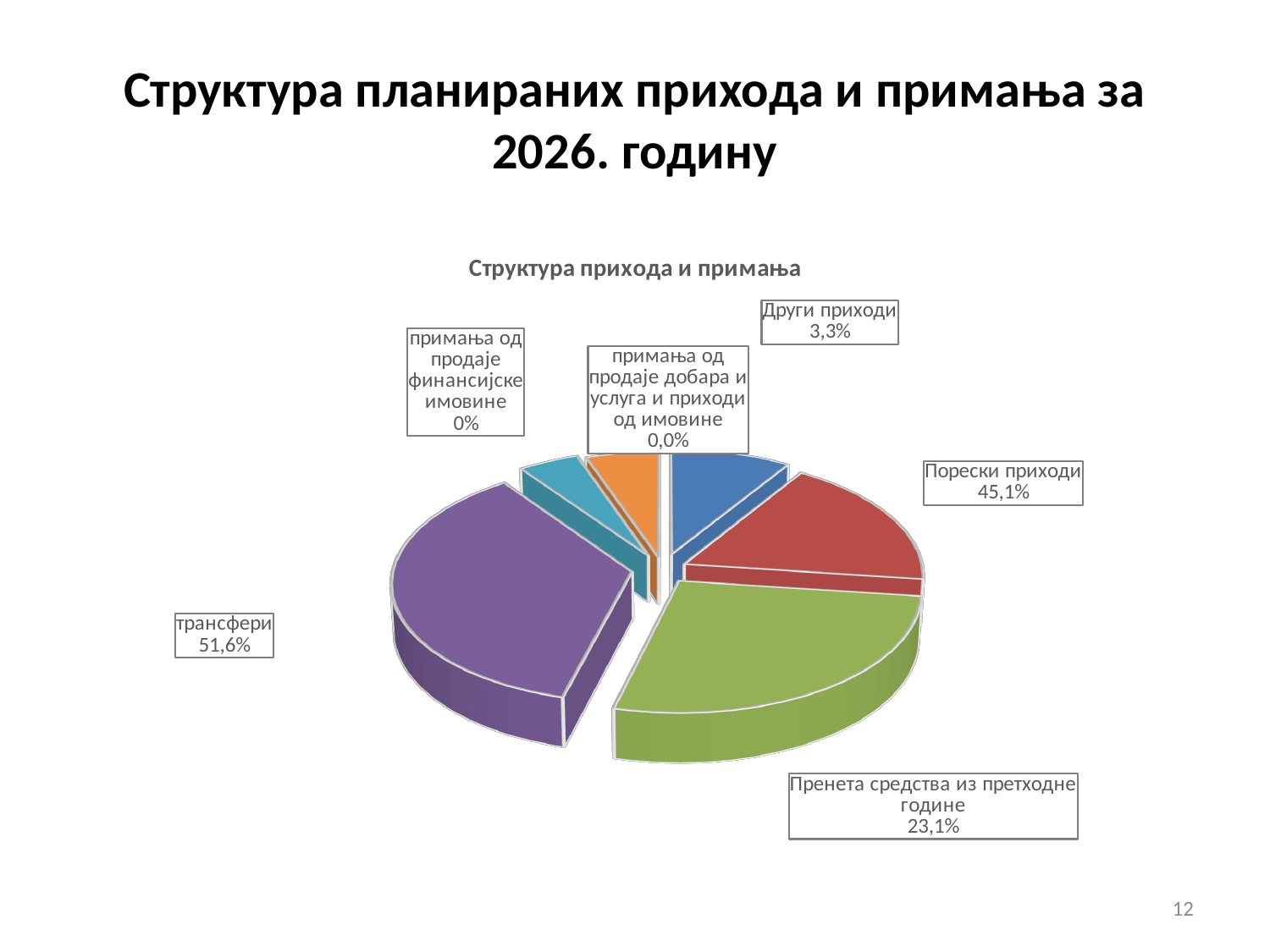
How many categories are labelled on the pie chart? 6 Which has the larger percentage label, Порески приходи or Пренета средства из претходне године? Порески приходи What is the title of the chart on the slide? Структура прихода и примања What percentage is shown for Порески приходи? 45,1% What percentage is shown for Пренета средства из претходне године? 23,1% What percentage is shown for трансфери? 51,6% What colour is the slice labelled трансфери? purple What is the difference between the percentage labels for трансфери and Порески приходи? 6,5% Which category has the highest percentage label on the chart? трансфери What percentage is shown for Други приходи? 3,3% What percentage is shown for примања од продаје добара и услуга и приходи од имовине? 0,0% What kind of chart is shown on the slide? pie chart